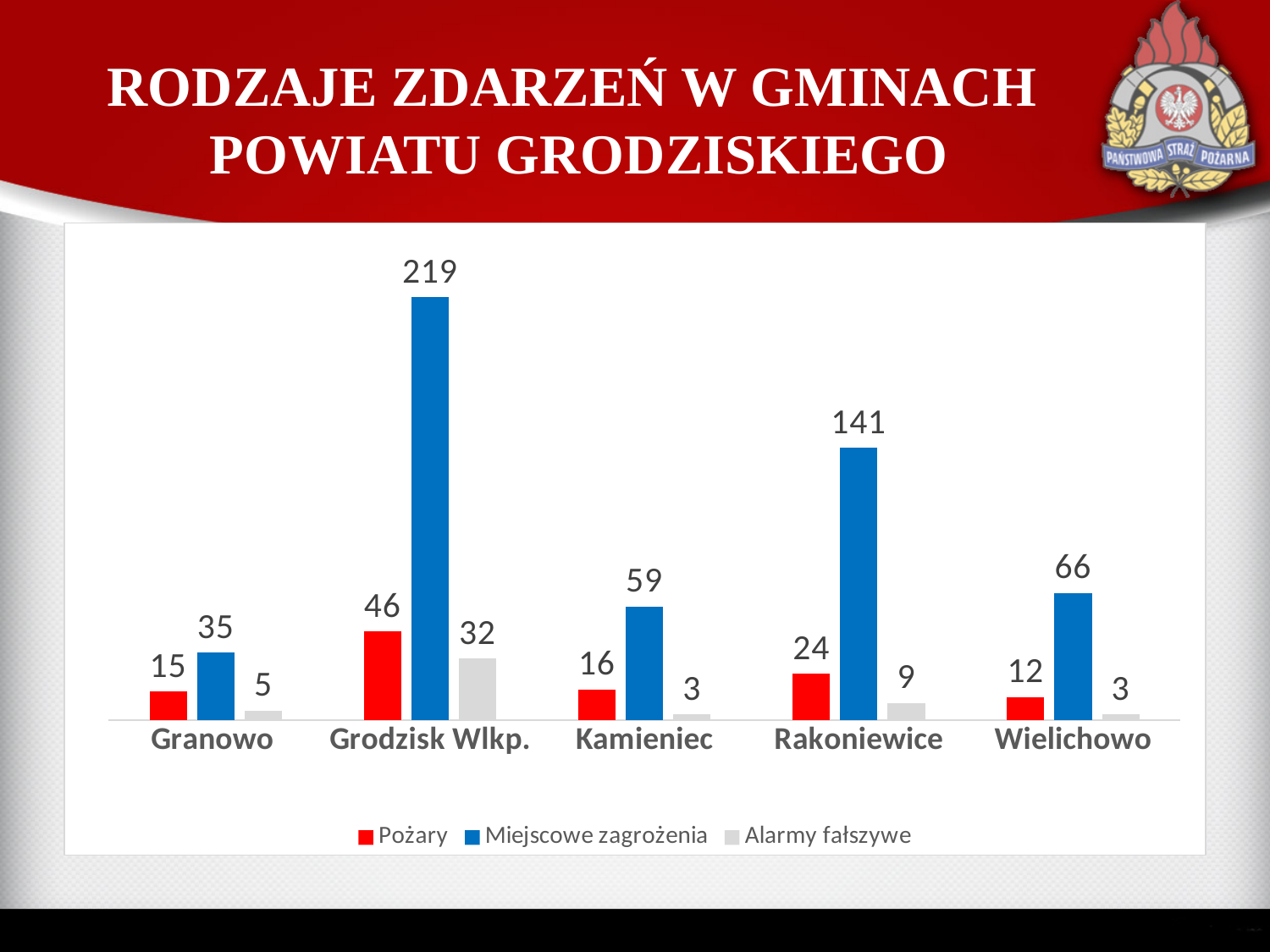
What is the value of Miejscowe zagrożenia for Grodzisk Wlkp.? 219 How many series does the legend list? 3 What is the value of Pożary for Rakoniewice? 24 Which gmina has the lowest value for Pożary? Wielichowo Which series is shown in red in the legend? Pożary Which is larger: Pożary for Granowo or Pożary for Kamieniec? Pożary for Kamieniec How many gminas are shown on the x axis? 5 What is the total of the three values for Kamieniec? 78 What is the difference between Miejscowe zagrożenia for Grodzisk Wlkp. and Rakoniewice? 78 Which gmina has the highest value for Miejscowe zagrożenia? Grodzisk Wlkp. What kind of chart is shown on the slide? Bar chart What is the value of Alarmy fałszywe for Wielichowo? 3